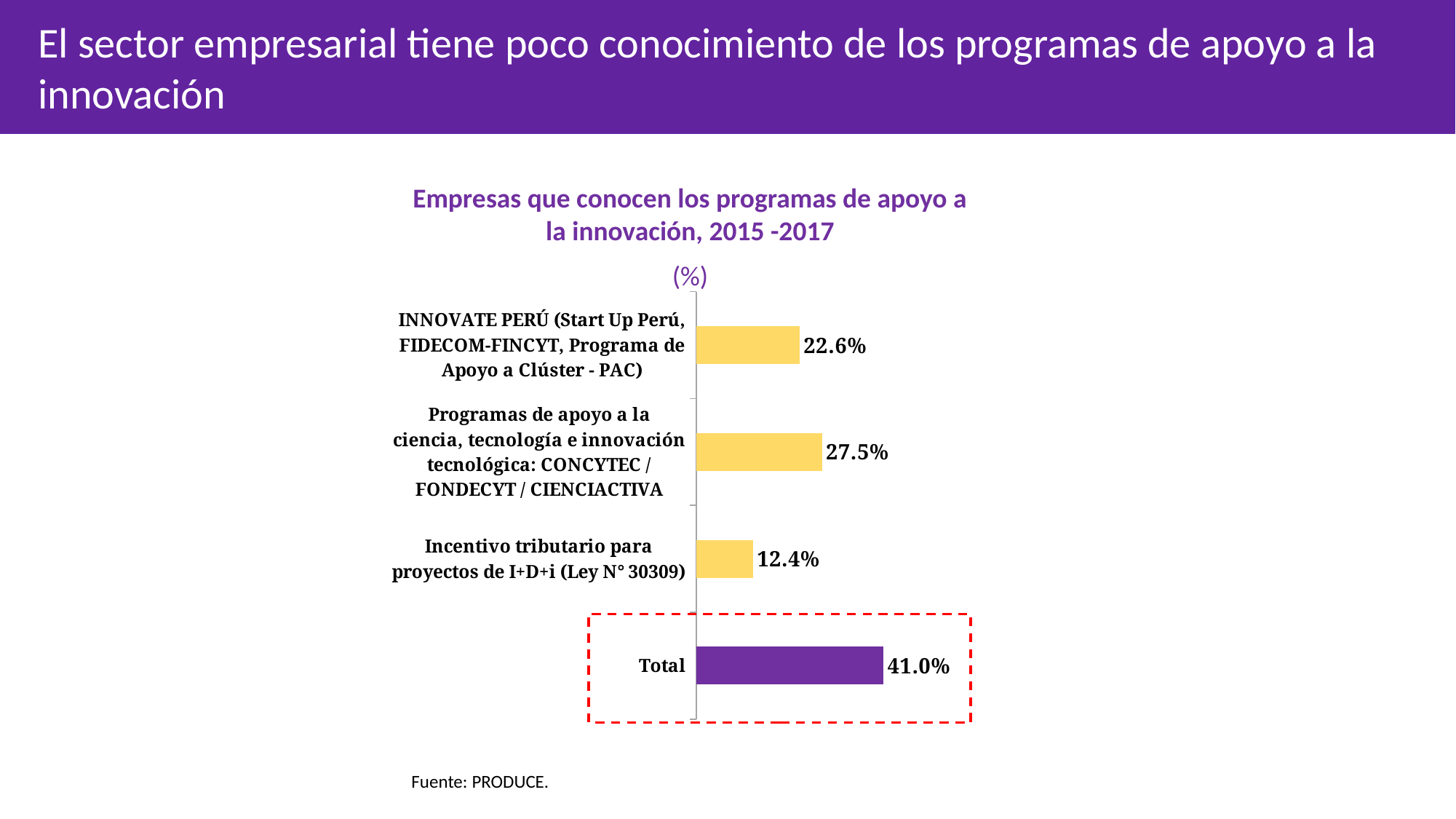
What type of chart is shown on the slide? Bar chart What percentage of companies know the INNOVATE PERÚ programs (Start Up Perú, FIDECOM-FINCYT, Programa de Apoyo a Clúster - PAC)? 22.6% How many bars are shown in the chart, including the Total? 4 What is the difference between the Total value and the Incentivo tributario value? 28.6% What is the value shown for the CONCYTEC / FONDECYT / CIENCIACTIVA programs? 27.5% What is the value of the Total bar? 41.0% Which category has the lowest value in the chart? Incentivo tributario para proyectos de I+D+i (Ley N° 30309) What is the difference between the CONCYTEC / FONDECYT / CIENCIACTIVA value and the INNOVATE PERÚ value? 4.9% What colour is the Total bar? Purple Excluding the Total bar, which program has the highest share of companies that know it? Programas de apoyo a la ciencia, tecnología e innovación tecnológica: CONCYTEC / FONDECYT / CIENCIACTIVA What percentage of companies know the Incentivo tributario para proyectos de I+D+i (Ley N° 30309)? 12.4% Which is larger: the value for INNOVATE PERÚ or the value for Incentivo tributario para proyectos de I+D+i? INNOVATE PERÚ